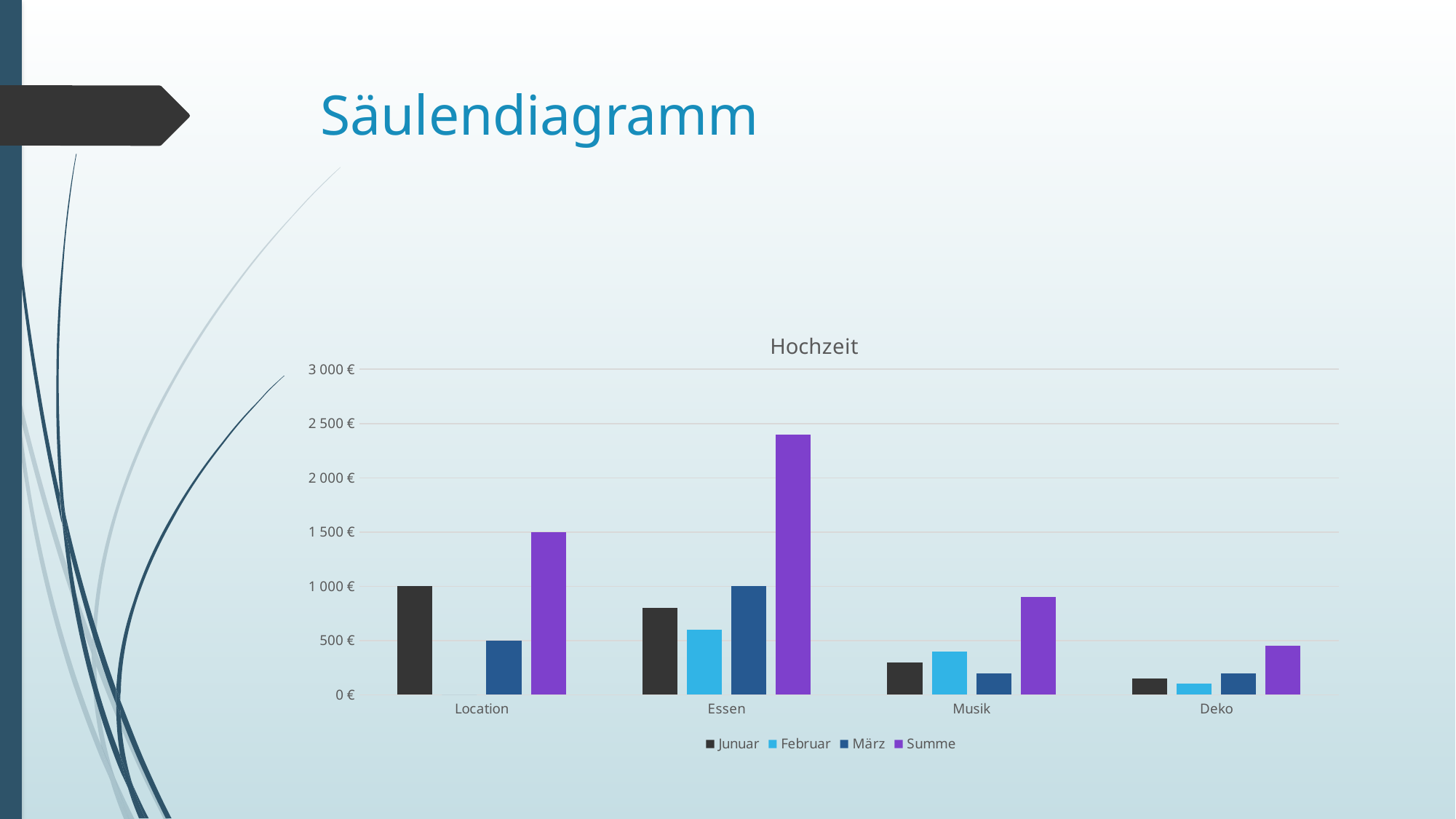
How many categories are shown on the x axis? 4 What is the title of the chart? Hochzeit Which category has the lowest Summe value? Deko What is the difference between the Summe value and the Junuar value for Location? 500 € Is the Summe value for Essen greater or less than 2 000 €? greater What kind of chart is shown on the slide? bar chart Which is larger, the Junuar value for Location or the Junuar value for Essen? Location How many series does the legend list? 4 What is the März value for Essen? 1 000 € What is the Junuar value for Location? 1 000 € What is the Summe value for Location? 1 500 € Which category has the highest Summe value? Essen